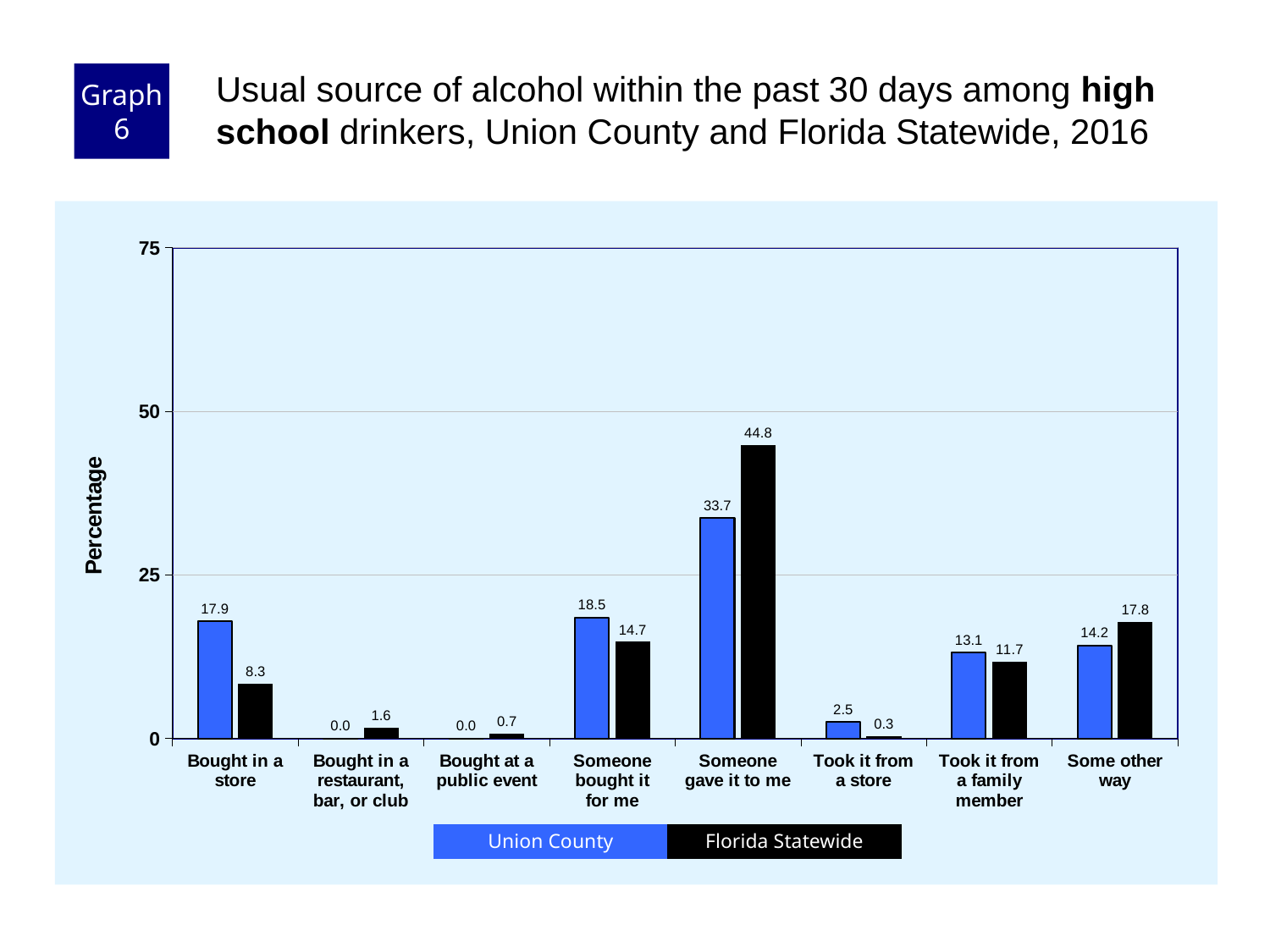
Which is larger for "Someone bought it for me": Union County or Florida Statewide? Union County What is the Florida Statewide value for "Bought in a store"? 8.3 Is the Union County value for "Someone gave it to me" greater or less than 25? greater How many source categories are shown on the x axis? 8 How many series does the legend list? 2 Which category has the highest Florida Statewide value? Someone gave it to me What kind of chart is shown on the slide? Bar chart What is the Union County value for "Took it from a family member"? 13.1 What is the difference between the Florida Statewide and Union County values for "Someone gave it to me"? 11.1 Which category has the lowest Florida Statewide value? Took it from a store What colour are the Florida Statewide bars? Black What is the Union County value for "Someone gave it to me"? 33.7